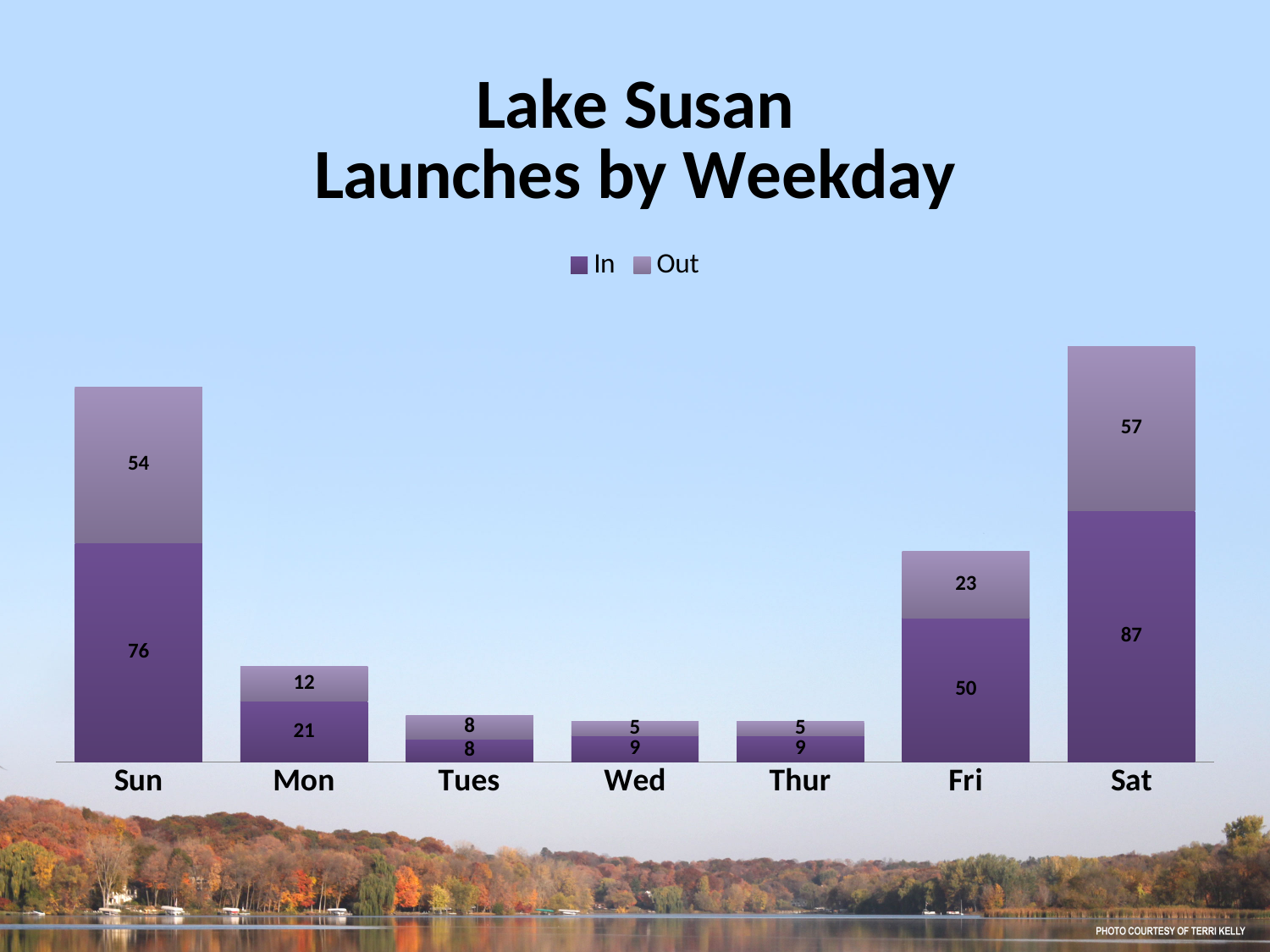
Which is larger, the Out value for Sun or the Out value for Fri? Sun What kind of chart is shown on the slide? Stacked bar chart What is the title of the chart? Lake Susan Launches by Weekday What is the value of the Out series for Fri? 23 What is the total of the stacked bar for Sat? 144 What is the difference between the In values for Sat and Sun? 11 What is the value of the In series for Sun? 76 Which weekday has the lowest Out value? Wed and Thur How many series does the legend list? 2 What is the value of the Out series for Sat? 57 How many weekdays are shown on the x axis? 7 Which weekday has the highest In value? Sat